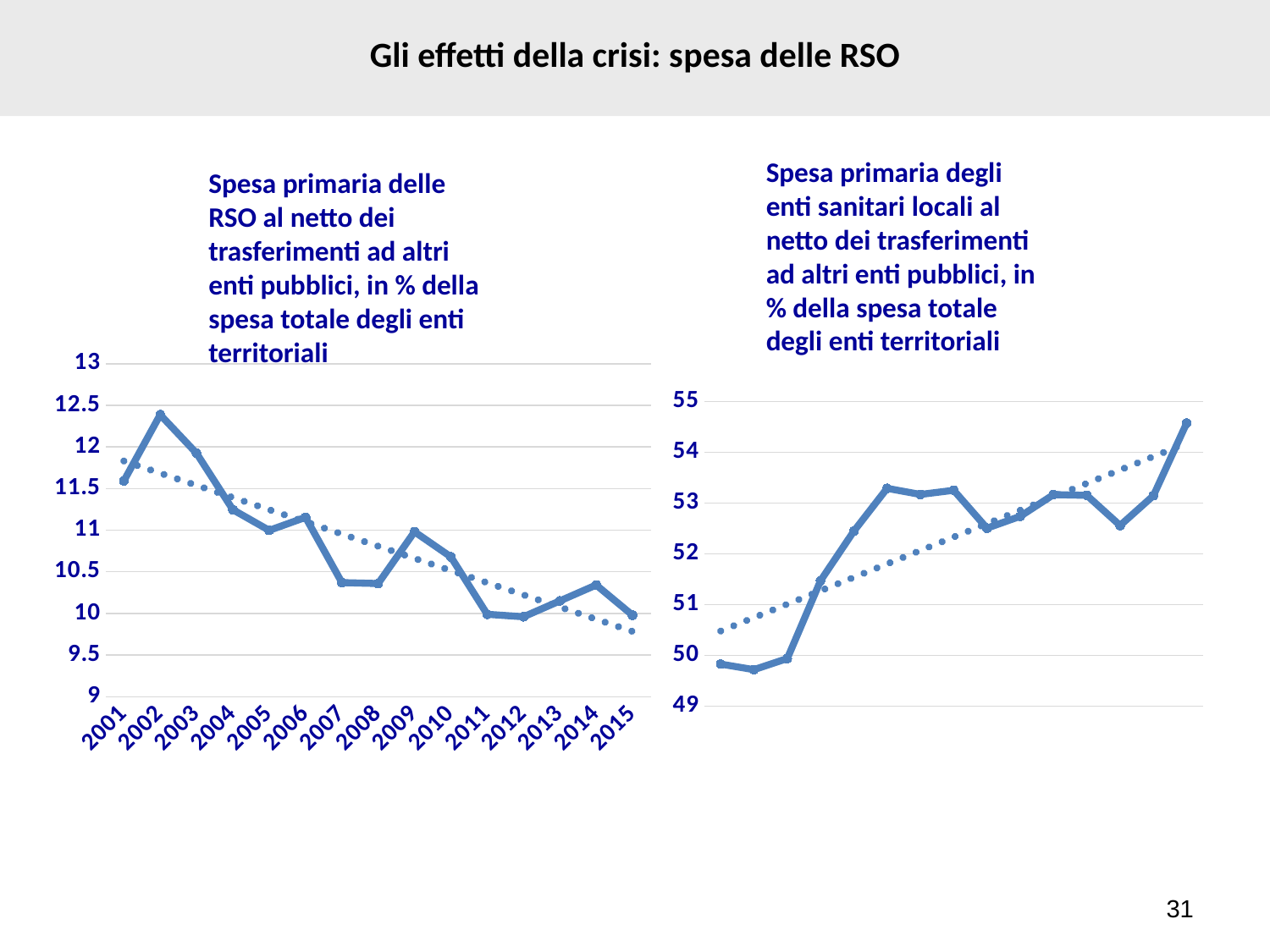
On the left chart (Spesa primaria delle RSO), how many years are shown on the x axis? 15 What is the highest value shown on the y axis of the right chart (Spesa primaria degli enti sanitari locali)? 55 On the left chart (Spesa primaria delle RSO), which year has the highest value? 2002 What kind of chart is the left chart (Spesa primaria delle RSO)? line chart On the right chart (Spesa primaria degli enti sanitari locali), do the values generally rise or fall along the x axis? rise On the left chart (Spesa primaria delle RSO), is the value for 2007 greater or less than 10.5? less On the left chart (Spesa primaria delle RSO), is the value for 2002 greater or less than 12? greater On the left chart (Spesa primaria delle RSO), do the values generally rise or fall from 2001 to 2015? fall On the left chart (Spesa primaria delle RSO), which year has the larger value, 2003 or 2005? 2003 On the left chart (Spesa primaria delle RSO), is the value for 2009 greater or less than 10.5? greater What kind of chart is the right chart (Spesa primaria degli enti sanitari locali)? line chart